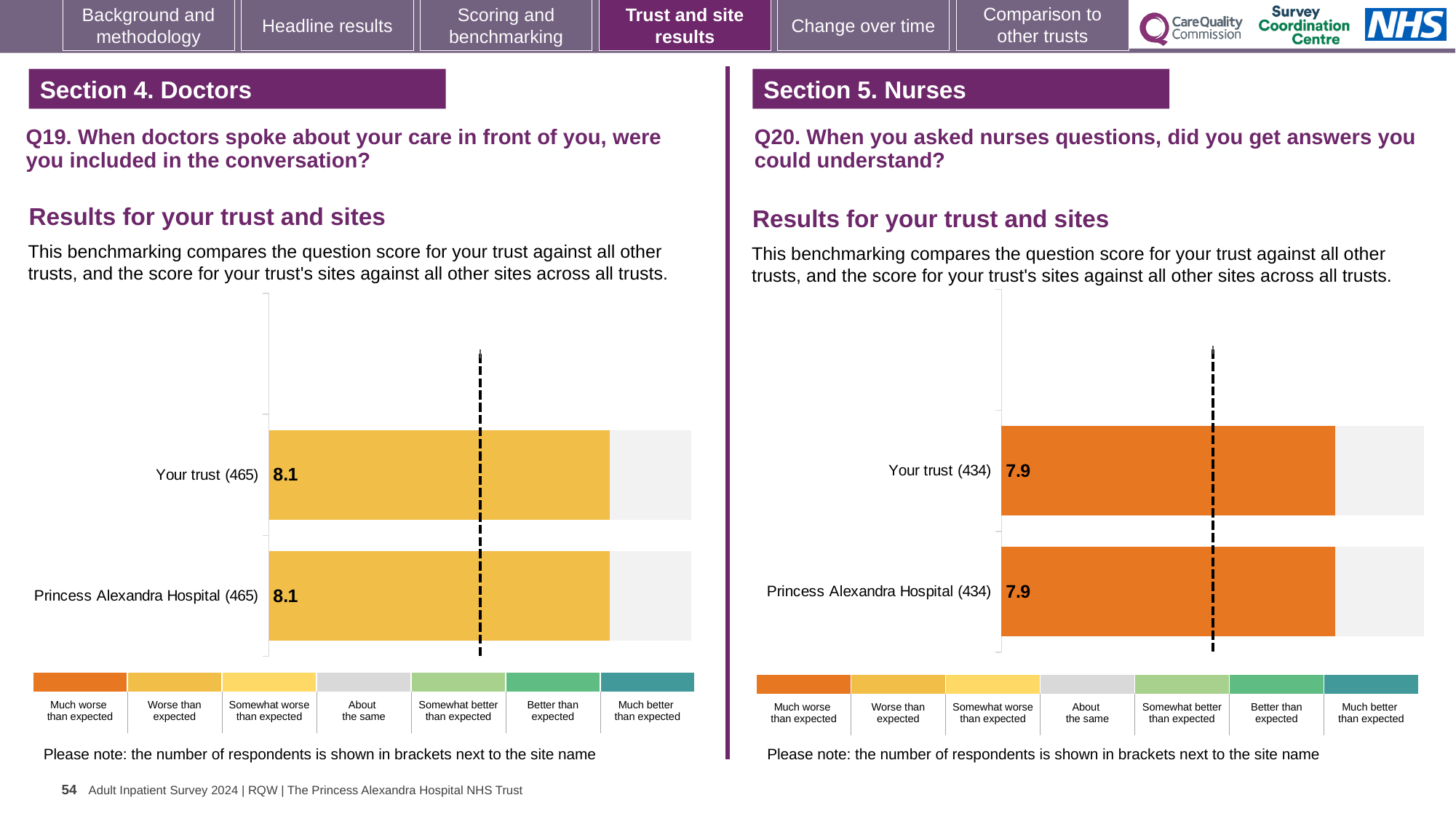
On the Q20 chart (right), what is the score for Your trust? 7.9 On the Q20 chart (right), what is the difference between the Your trust score and the Princess Alexandra Hospital score? 0 On the Q19 chart (left), what is the difference between the Your trust score and the Princess Alexandra Hospital score? 0 On the Q19 chart (left), what is the score for Your trust? 8.1 How many bars are plotted on the Q20 chart (right)? 2 How many bars are plotted on the Q19 chart (left)? 2 What kind of chart is used for the Q20 results (right)? bar chart Is the Your trust score on the Q19 chart (left) larger or smaller than the Your trust score on the Q20 chart (right)? larger How many benchmark categories does the legend below the Q19 chart (left) list? 7 On the Q20 chart (right), what is the score for Princess Alexandra Hospital? 7.9 On the Q19 chart (left), what is the score for Princess Alexandra Hospital? 8.1 How many respondents are shown in brackets for Your trust on the Q20 chart (right)? 434